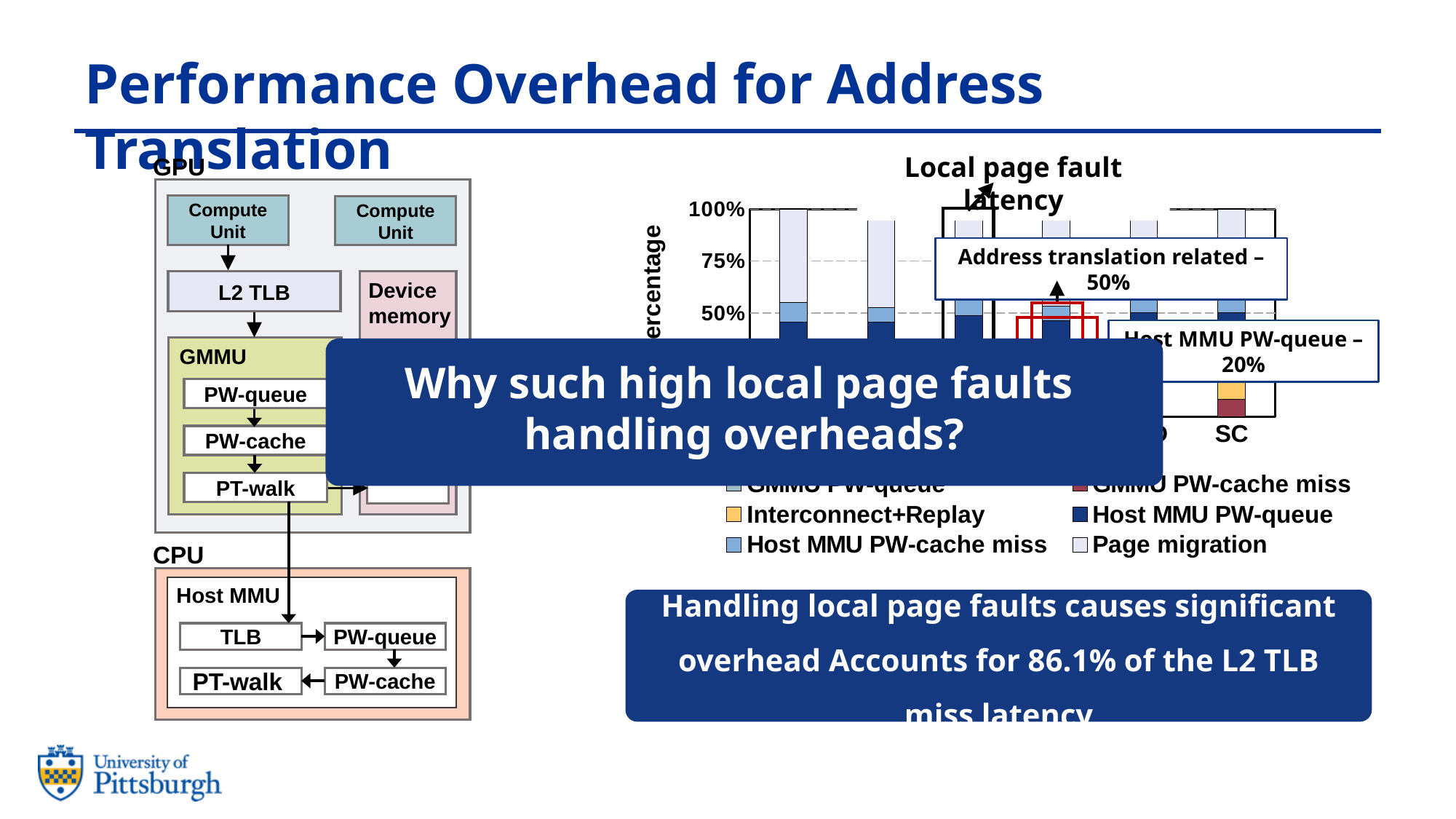
What is the label of the rightmost category visible on the x-axis of the 'Local page fault latency' chart? SC According to the annotation on the 'Local page fault latency' chart, what percentage is attributed to Host MMU PW-queue? 20% How many series does the legend of the 'Local page fault latency' chart list? 6 According to the annotation on the 'Local page fault latency' chart, what percentage is address translation related? 50% What kind of chart is shown on the right side of the slide? Stacked bar chart In the 'Local page fault latency' chart, which legend entry is shown in dark blue? Host MMU PW-queue What is the highest tick value shown on the y-axis of the 'Local page fault latency' chart? 100% What is the title of the chart on the right side of the slide? Local page fault latency